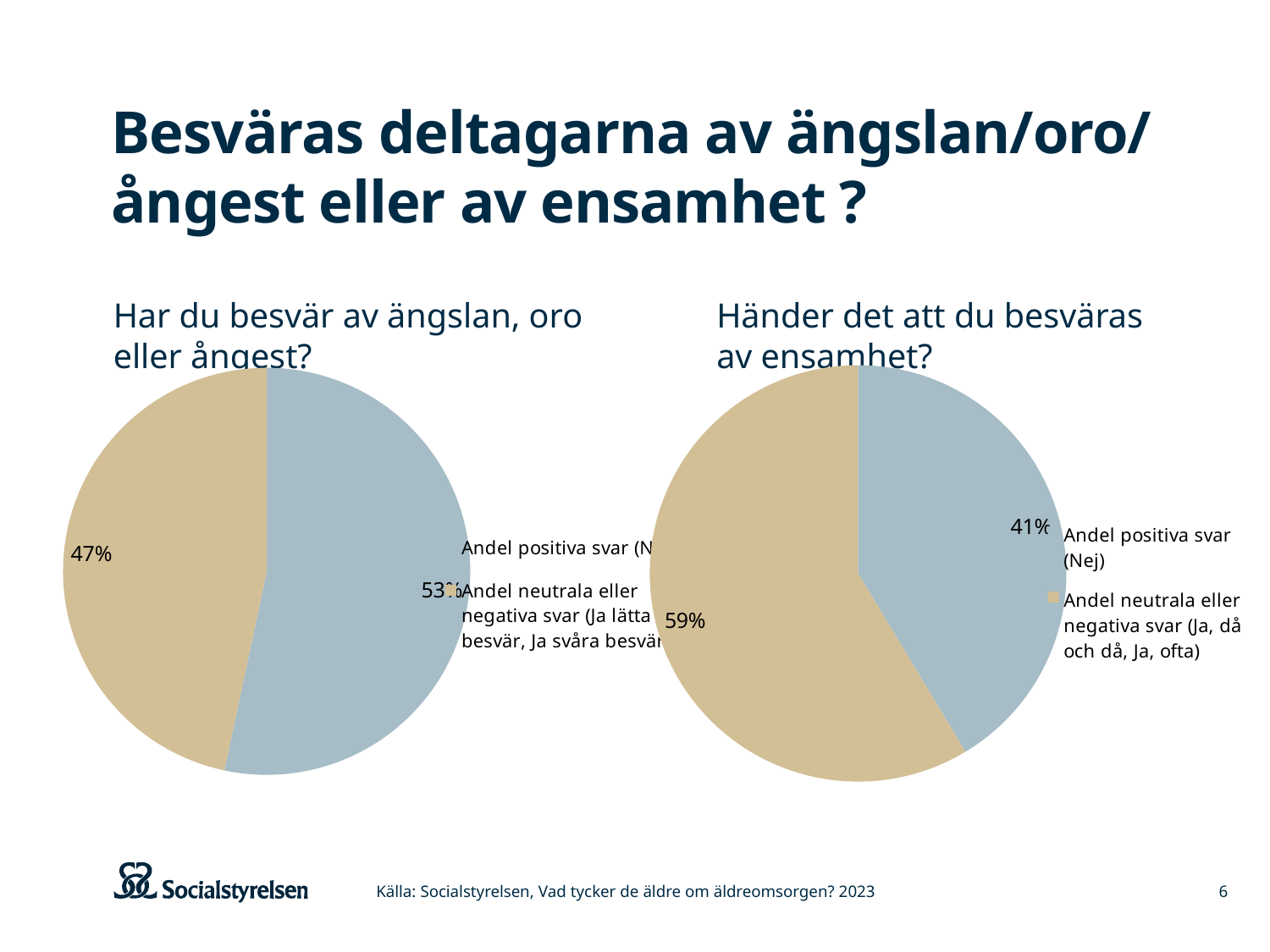
In the left pie chart (Har du besvär av ängslan, oro eller ångest?), what is the difference in percentage points between the positive share and the neutral/negative share? 6 percentage points In the right pie chart (Händer det att du besväras av ensamhet?), which slice is the largest? Andel neutrala eller negativa svar (Ja, då och då, Ja, ofta) Which is larger: the positive share (Nej) in the left chart or the positive share (Nej) in the right chart? The left chart (53%) In the left pie chart (Har du besvär av ängslan, oro eller ångest?), what share is labelled for the blue slice (Andel positiva svar)? 53% In the left pie chart (Har du besvär av ängslan, oro eller ångest?), what share is labelled for the tan slice (Andel neutrala eller negativa svar)? 47% In the right pie chart (Händer det att du besväras av ensamhet?), what share is labelled for Andel neutrala eller negativa svar (Ja, då och då, Ja, ofta)? 59% What type of chart is used for 'Händer det att du besväras av ensamhet?'? Pie chart How many slices does the right pie chart (Händer det att du besväras av ensamhet?) have? 2 In the right pie chart (Händer det att du besväras av ensamhet?), what share is labelled for Andel positiva svar (Nej)? 41% How many entries does the legend of the right pie chart (Händer det att du besväras av ensamhet?) list? 2 In the right pie chart (Händer det att du besväras av ensamhet?), what is the difference in percentage points between the neutral/negative share and the positive share? 18 percentage points In the left pie chart (Har du besvär av ängslan, oro eller ångest?), which slice is the smallest? Andel neutrala eller negativa svar